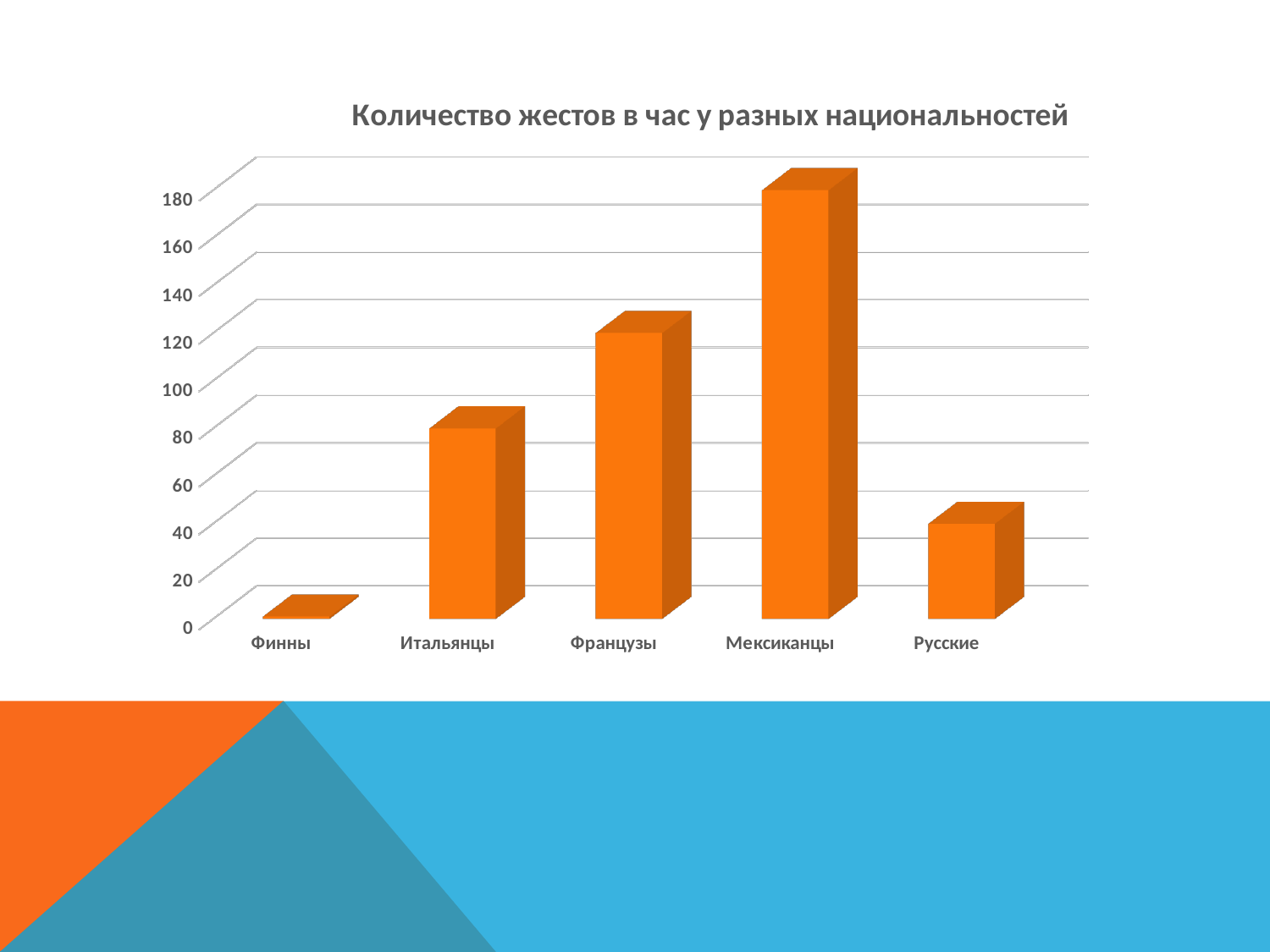
Which is larger, the value for Русские or the value for Мексиканцы? Мексиканцы Is the value for Французы greater or less than 140? less What kind of chart is shown on the slide? bar chart Is the value for Итальянцы greater or less than 60? greater Is the value for Финны greater or less than 20? less How many nationalities (categories) are shown on the chart? 5 Which is larger, the value for Французы or the value for Итальянцы? Французы What is the title of the chart? Количество жестов в час у разных национальностей Which nationality has the lowest number of gestures per hour? Финны Which nationality has the highest number of gestures per hour? Мексиканцы